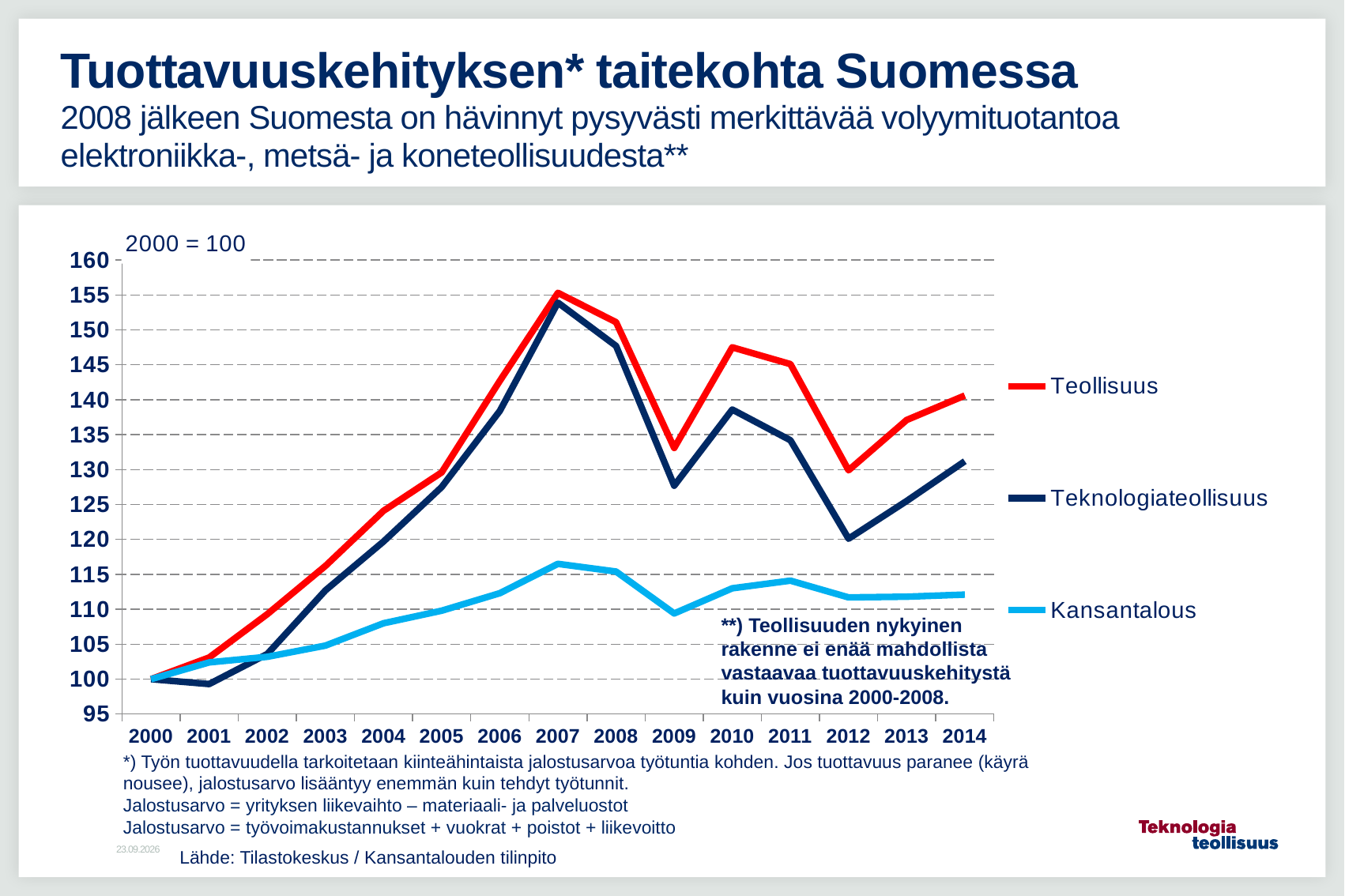
Is the value for Kansantalous in 2007 greater or less than 110? greater In which year does the Teollisuus series reach its highest value? 2007 What kind of chart is shown on the slide? line chart Does the Teknologiateollisuus series rise or fall between 2007 and 2009? fall Is the value for Teknologiateollisuus in 2012 greater or less than 125? less What is the index value of all three series in 2000? 100 Is the value for Teollisuus in 2007 greater or less than 150? greater Which series has the higher value in 2014, Teollisuus or Kansantalous? Teollisuus How many series does the legend list? 3 In which year does the Teknologiateollisuus series reach its highest value? 2007 How many years are plotted along the x axis? 15 In which year is the Kansantalous series at its lowest value? 2000